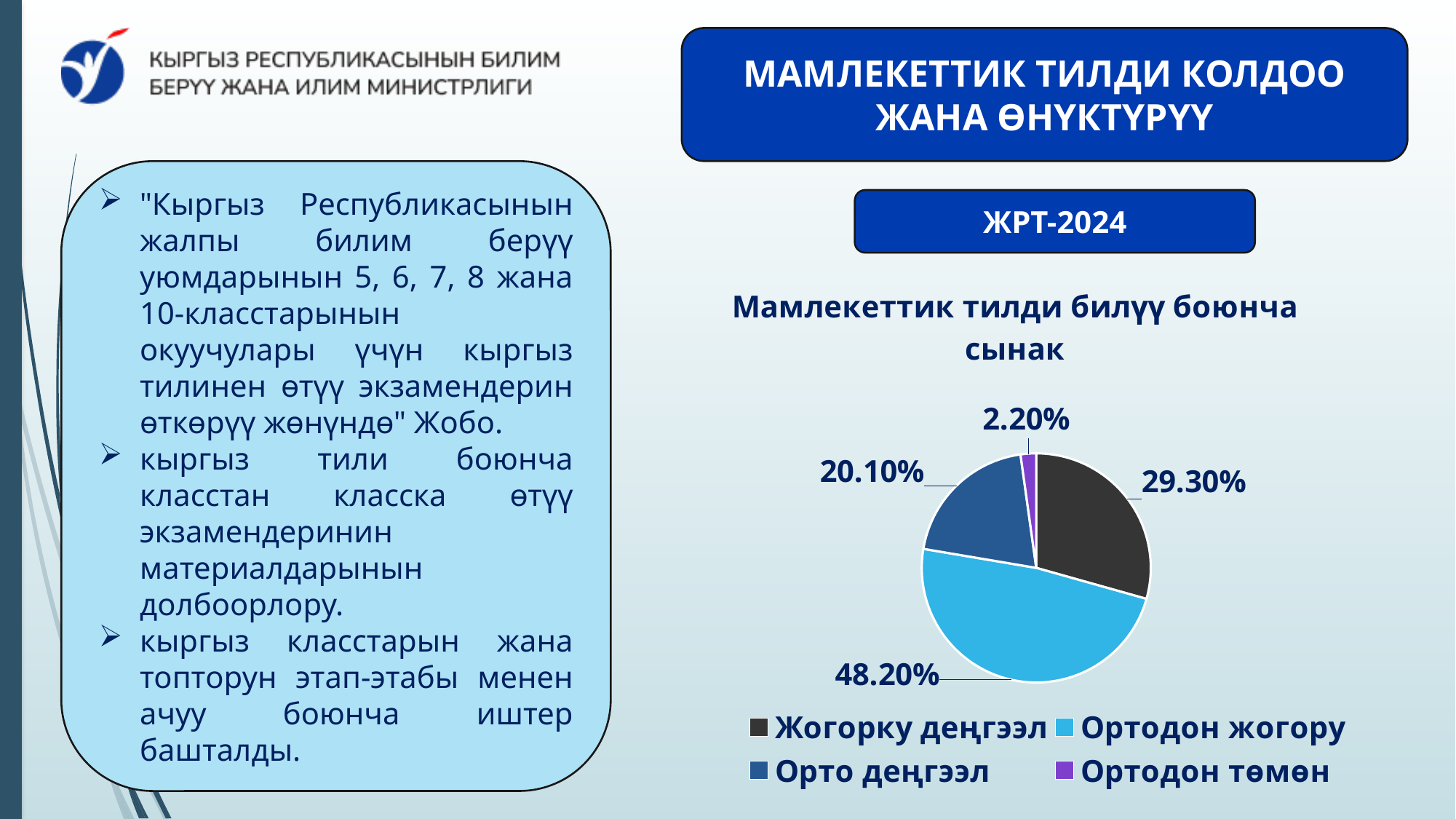
What share of the pie does "Жогорку деңгээл" have? 29.30% What is the difference between the shares of "Ортодон жогору" and "Жогорку деңгээл"? 18.90% Which is larger, the share of "Жогорку деңгээл" or the share of "Орто деңгээл"? Жогорку деңгээл What is the title of the chart? Мамлекеттик тилди билүү боюнча сынак Which category has the largest slice of the pie? Ортодон жогору What share of the pie does "Орто деңгээл" have? 20.10% What share of the pie does "Ортодон төмөн" have? 2.20% Which category is shown in purple in the legend? Ортодон төмөн What share of the pie does "Ортодон жогору" have? 48.20% How many slices does the pie chart have? 4 What kind of chart is shown on the slide? pie chart Which category has the smallest slice of the pie? Ортодон төмөн